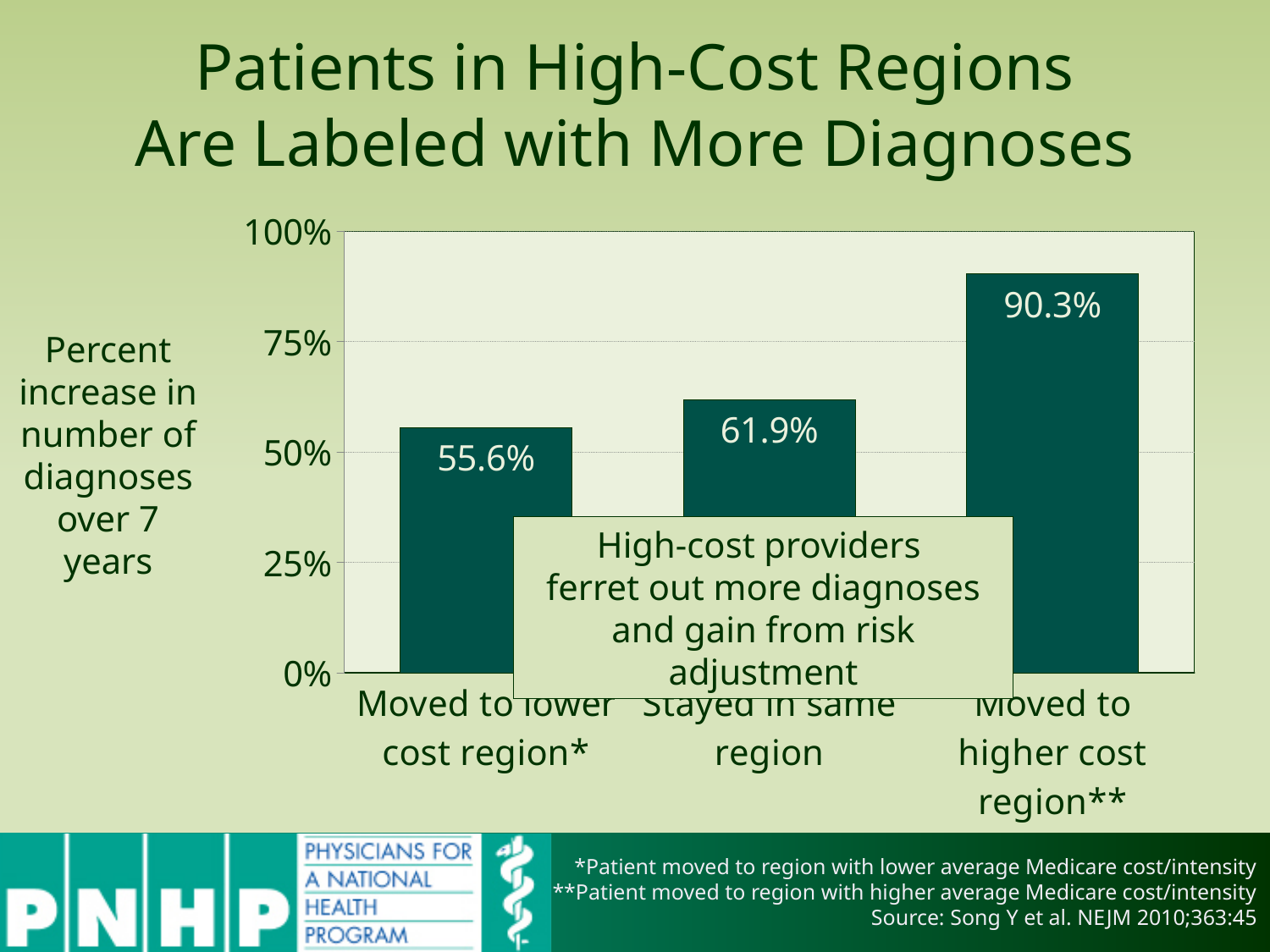
What is the percent increase in number of diagnoses for patients who moved to a lower cost region? 55.6% What is the percent increase in number of diagnoses for patients who stayed in the same region? 61.9% Which category has the highest percent increase in number of diagnoses? Moved to higher cost region Do the values rise or fall moving from left to right across the categories? Rise What is the percent increase in number of diagnoses for patients who moved to a higher cost region? 90.3% What kind of chart is shown on the slide? Bar chart Is the value for patients who moved to a higher cost region greater or less than 75%? greater What is the difference in percent increase between patients who stayed in the same region and those who moved to a lower cost region? 6.3 percentage points Which category has the lowest percent increase in number of diagnoses? Moved to lower cost region Which is larger: the percent increase for patients who stayed in the same region or for those who moved to a lower cost region? Stayed in same region What is the difference in percent increase between patients who moved to a higher cost region and those who moved to a lower cost region? 34.7 percentage points How many categories are shown on the chart? 3